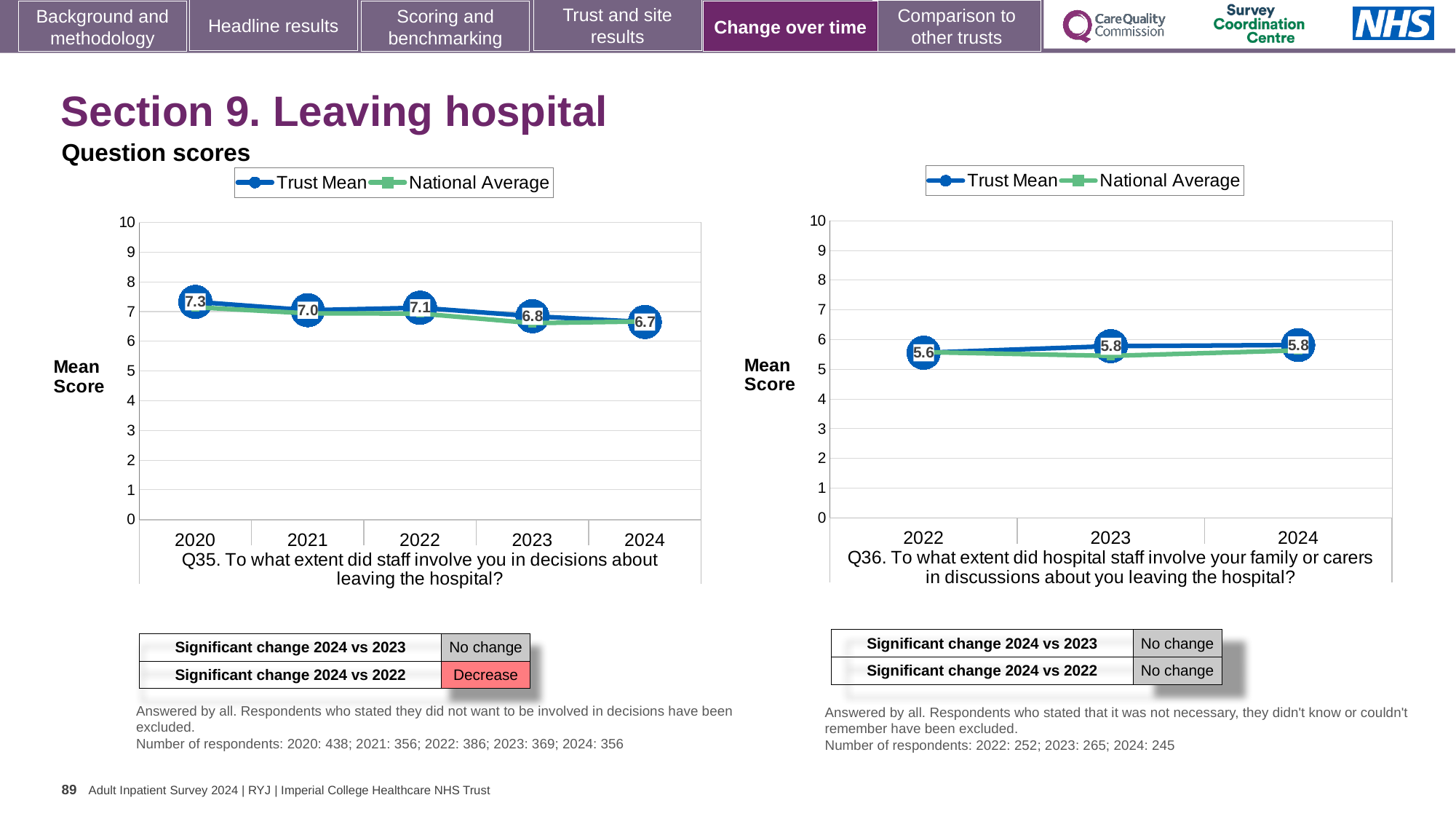
In the Q35 chart (left), which year has the lowest Trust Mean? 2024 In the Q36 chart (right), is the Trust Mean for 2024 greater or less than 6? less In the Q35 chart (left), what is the difference between the Trust Mean in 2020 and in 2024? 0.6 In the Q35 chart (left), which year has the highest Trust Mean? 2020 How many series does the legend of the Q36 chart (right) list? 2 What kind of chart is the Q35 chart (left)? line chart In the Q36 chart (right), is the Trust Mean for 2023 larger or smaller than the Trust Mean for 2022? larger In the Q35 chart (left), what is the Trust Mean for 2020? 7.3 In the Q35 chart (left), what is the Trust Mean for 2024? 6.7 In the Q35 chart (left), how many years are plotted on the x axis? 5 In the Q36 chart (right), what is the Trust Mean for 2022? 5.6 In the Q35 chart (left), does the Trust Mean generally rise or fall from 2020 to 2024? fall